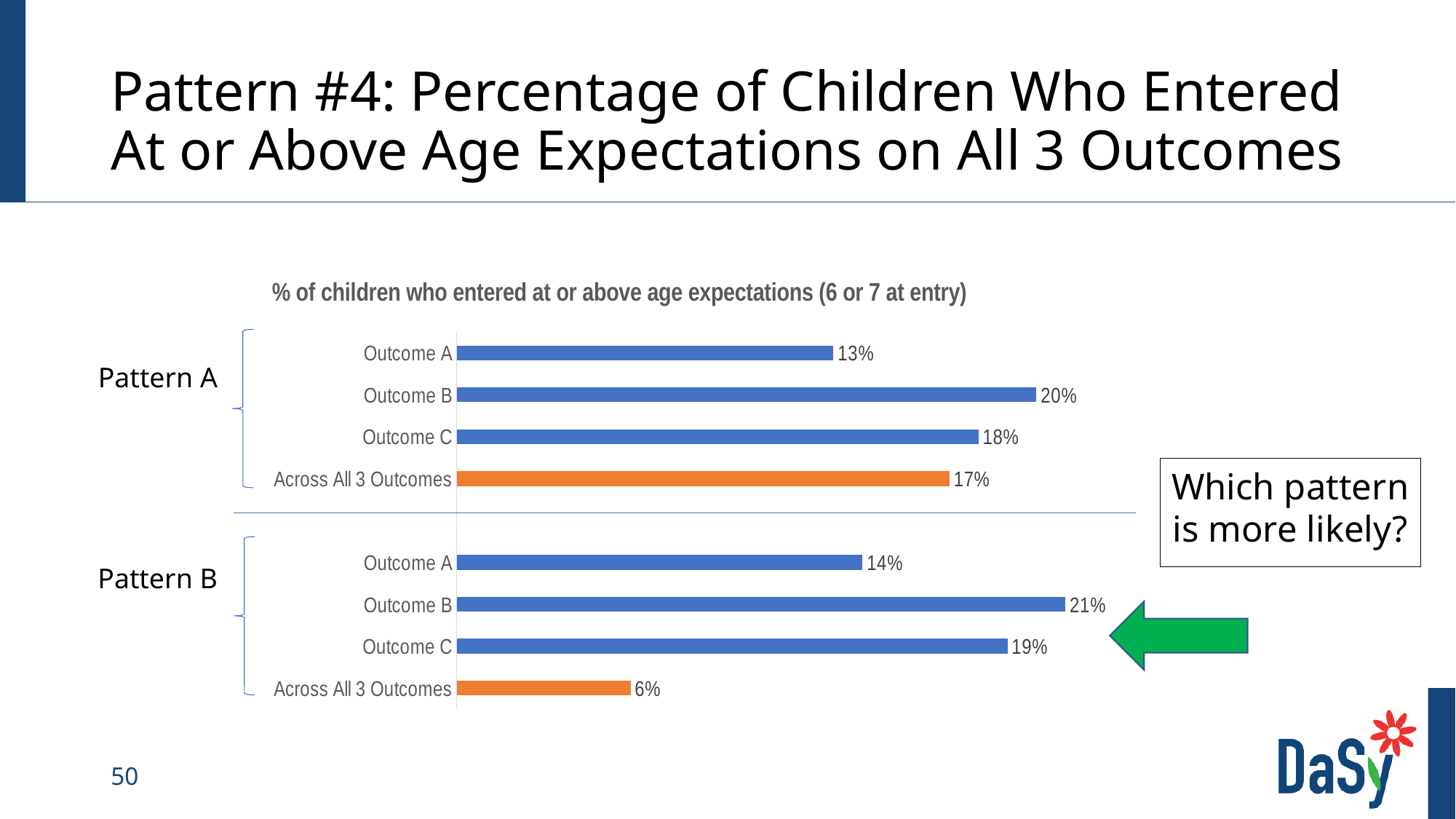
How many bars are plotted in the chart in total? 8 What is the title of the chart? % of children who entered at or above age expectations (6 or 7 at entry) What is the value for Across All 3 Outcomes under Pattern B? 6% What is the difference between the Across All 3 Outcomes values for Pattern A and Pattern B? 11% Which bar has the highest value in the chart? Outcome B (Pattern B) Which is larger: Outcome C under Pattern A or Outcome C under Pattern B? Outcome C under Pattern B What kind of chart is shown on the slide? Bar chart What is the value for Outcome C under Pattern A? 18% What is the value for Outcome B under Pattern A? 20% Which bar has the lowest value in the chart? Across All 3 Outcomes (Pattern B) What is the difference between Outcome B and Outcome A under Pattern A? 7% What is the value for Outcome A under Pattern B? 14%